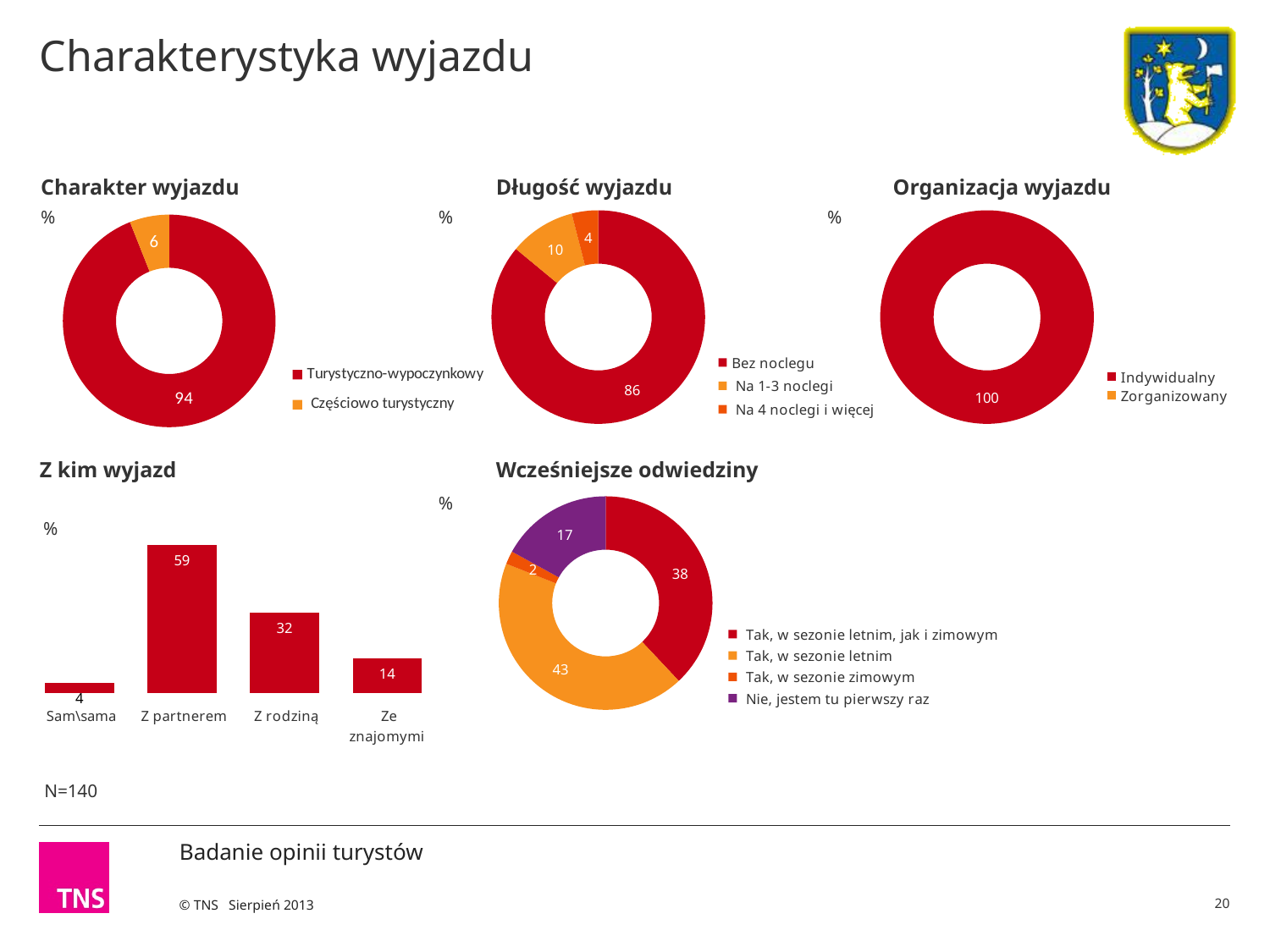
In the 'Z kim wyjazd' chart, what is the difference between 'Z partnerem' and 'Z rodziną'? 27 In the 'Organizacja wyjazdu' chart, what is the value for 'Indywidualny'? 100 In the 'Wcześniejsze odwiedziny' chart, which is larger: 'Tak, w sezonie letnim' or 'Tak, w sezonie letnim, jak i zimowym'? Tak, w sezonie letnim In the 'Długość wyjazdu' chart, which category has the largest share? Bez noclegu How many entries does the legend of the 'Wcześniejsze odwiedziny' chart list? 4 What kind of chart is 'Z kim wyjazd'? Bar chart In the 'Z kim wyjazd' chart, which category has the lowest value? Sam\sama In the 'Wcześniejsze odwiedziny' chart, what is the value for 'Nie, jestem tu pierwszy raz'? 17 In the 'Długość wyjazdu' chart, what is the value for 'Na 1-3 noclegi'? 10 In the 'Z kim wyjazd' chart, what is the value for 'Z partnerem'? 59 In the 'Charakter wyjazdu' chart, what is the value for 'Turystyczno-wypoczynkowy'? 94 How many categories are shown in the 'Z kim wyjazd' chart? 4